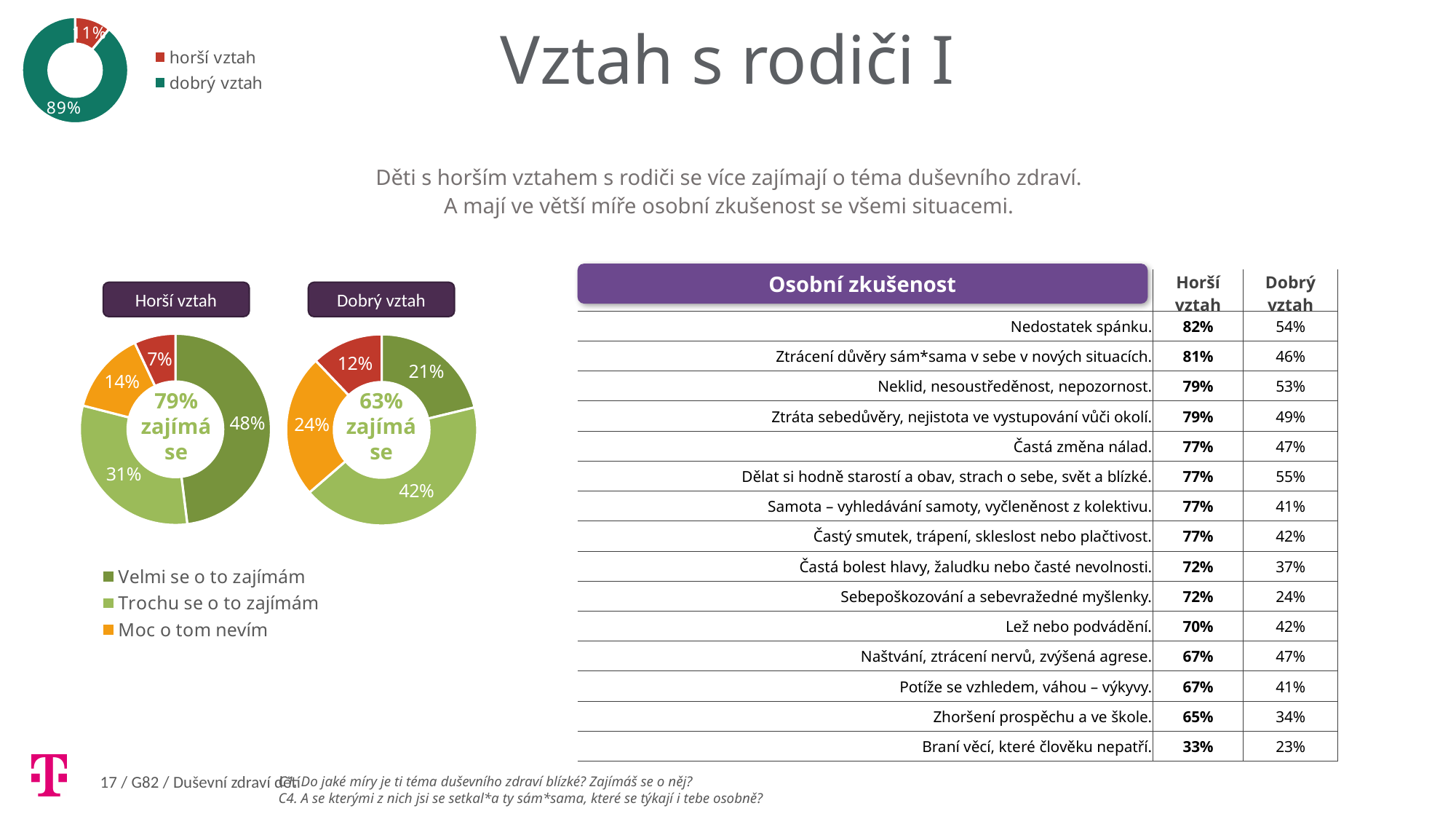
In the 'Horší vztah' donut chart, what is the difference in percentage points between 'Velmi se o to zajímám' and 'Trochu se o to zajímám'? 17 percentage points In the 'Horší vztah' donut chart, what is the value for 'Velmi se o to zajímám'? 48% What text is shown in the centre of the 'Horší vztah' donut chart? 79% zajímá se How many entries does the legend of the small donut chart at the top left of the slide list? 2 In the 'Dobrý vztah' donut chart, what is the value for 'Moc o tom nevím'? 24% In the small donut chart at the top left of the slide, what is the value for 'dobrý vztah'? 89% What is the difference in percentage points between 'Velmi se o to zajímám' in the 'Horší vztah' chart and in the 'Dobrý vztah' chart? 27 percentage points In the 'Dobrý vztah' donut chart, what is the value for 'Trochu se o to zajímám'? 42% In the 'Dobrý vztah' donut chart, which legend category has the largest slice? Trochu se o to zajímám What type of chart is the 'Horší vztah' chart? Donut (pie) chart In the 'Horší vztah' donut chart, which legend category has the largest slice? Velmi se o to zajímám Is the value for 'Moc o tom nevím' larger in the 'Horší vztah' chart or in the 'Dobrý vztah' chart? Dobrý vztah